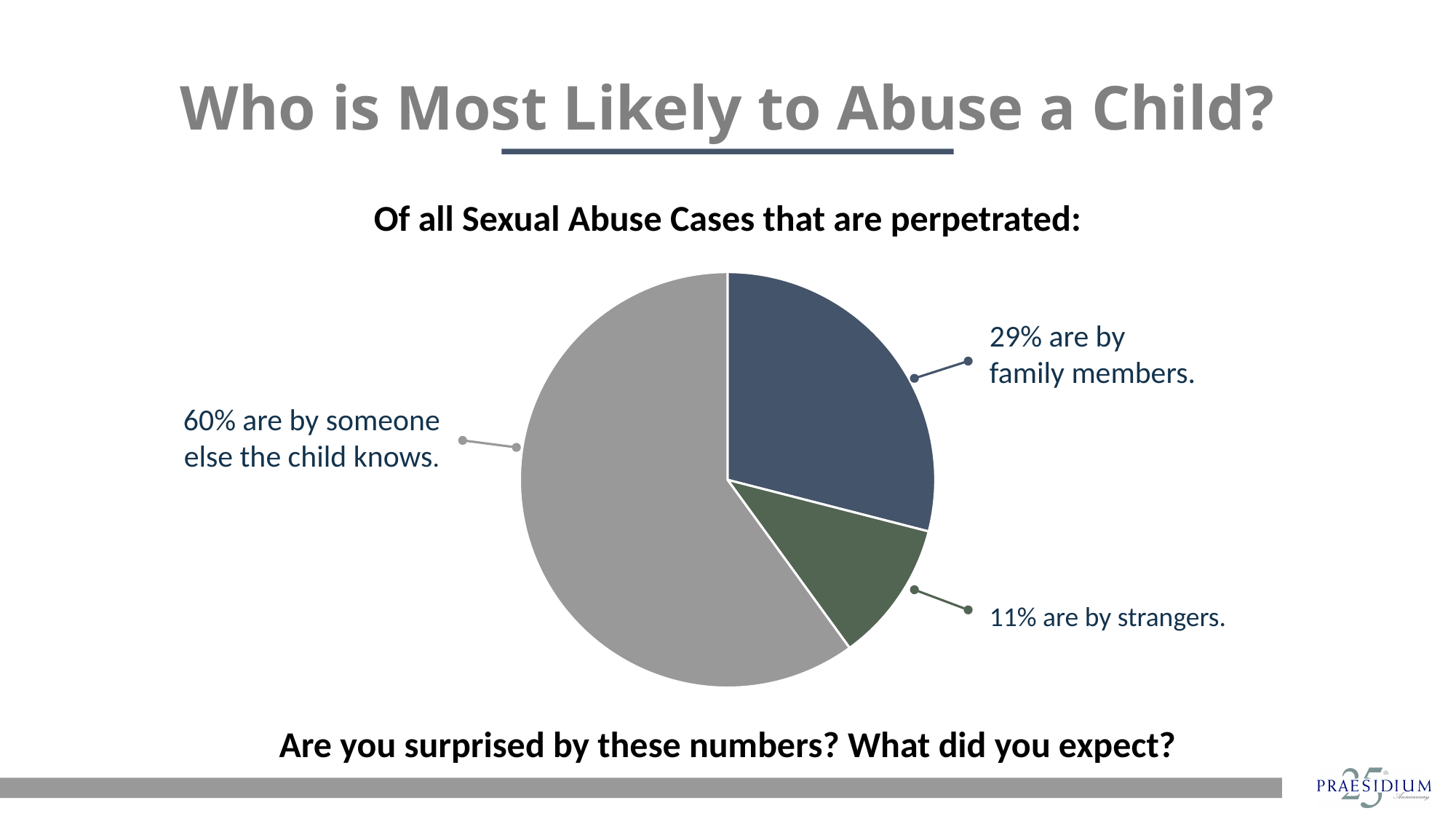
Which group accounts for the smallest share of sexual abuse cases? Strangers What percentage of sexual abuse cases are perpetrated by strangers? 11% What kind of chart is shown on the slide? Pie chart What colour is the slice representing cases by strangers? Green What percentage of sexual abuse cases are perpetrated by family members? 29% How many slices does the pie chart have? 3 What is the difference in percentage points between cases by someone else the child knows and cases by family members? 31 Which is larger: the share of cases by family members or the share by strangers? Family members What is the difference in percentage points between cases by family members and cases by strangers? 18 What is the heading printed directly above the pie chart? Of all Sexual Abuse Cases that are perpetrated: Which group accounts for the largest share of sexual abuse cases? Someone else the child knows What percentage of sexual abuse cases are perpetrated by someone else the child knows? 60%